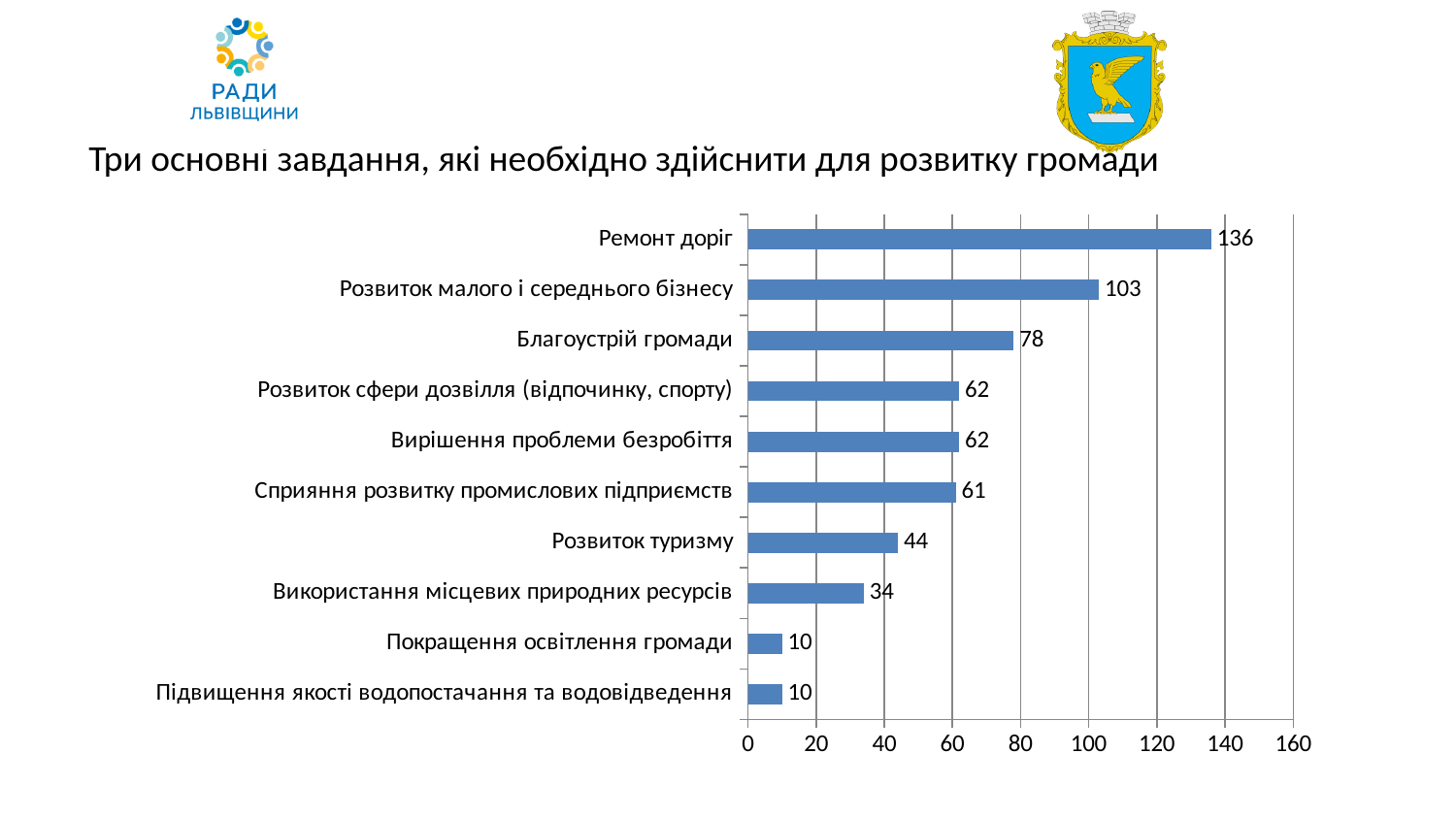
How many categories are shown in the chart? 10 What is the title of the chart? Три основні завдання, які необхідно здійснити для розвитку громади What kind of chart is shown on the slide? bar chart What is the value for Розвиток малого і середнього бізнесу? 103 Is the value for Розвиток малого і середнього бізнесу greater or less than 100? greater What is the difference between the values for Благоустрій громади and Розвиток туризму? 34 What is the value for Ремонт доріг? 136 What is the value for Використання місцевих природних ресурсів? 34 Which category has the highest value? Ремонт доріг Which is larger, the value for Благоустрій громади or the value for Сприяння розвитку промислових підприємств? Благоустрій громади What is the difference between the values for Ремонт доріг and Розвиток малого і середнього бізнесу? 33 What is the value for Розвиток туризму? 44